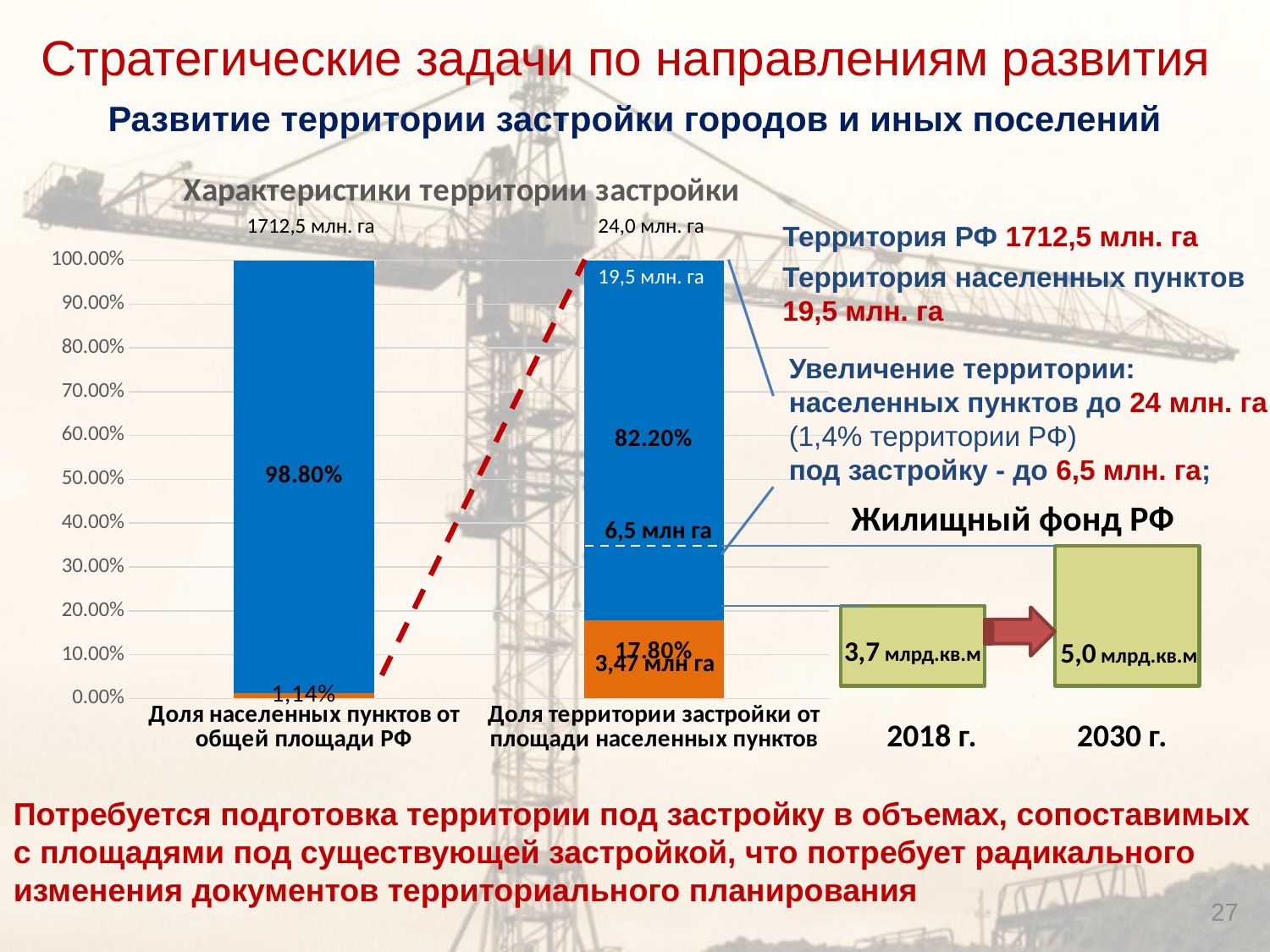
In the chart 'Характеристики территории застройки', what area label is printed above the bar for 'Доля населенных пунктов от общей площади РФ'? 1712,5 млн. га In the chart 'Характеристики территории застройки', is the orange segment for 'Доля территории застройки от площади населенных пунктов' greater or less than 20%? less In the chart 'Характеристики территории застройки', what area label is printed above the bar for 'Доля территории застройки от площади населенных пунктов'? 24,0 млн. га In the chart 'Характеристики территории застройки', which category has the larger orange segment? Доля территории застройки от площади населенных пунктов In the chart 'Характеристики территории застройки', what is the value of the blue segment for 'Доля населенных пунктов от общей площади РФ'? 98.80% In the chart 'Характеристики территории застройки', what is the value of the blue segment for 'Доля территории застройки от площади населенных пунктов'? 82.20% How many categories are shown on the x axis of the chart 'Характеристики территории застройки'? 2 What is the title of the bar chart on the slide? Характеристики территории застройки In the chart 'Характеристики территории застройки', what is the value of the orange segment for 'Доля населенных пунктов от общей площади РФ'? 1,14% What kind of chart is 'Характеристики территории застройки'? Stacked bar chart In the chart 'Характеристики территории застройки', what is the value of the orange segment for 'Доля территории застройки от площади населенных пунктов'? 17.80% In the chart 'Характеристики территории застройки', what is the difference between the blue segment values of the two categories (98.80% and 82.20%)? 16.60%